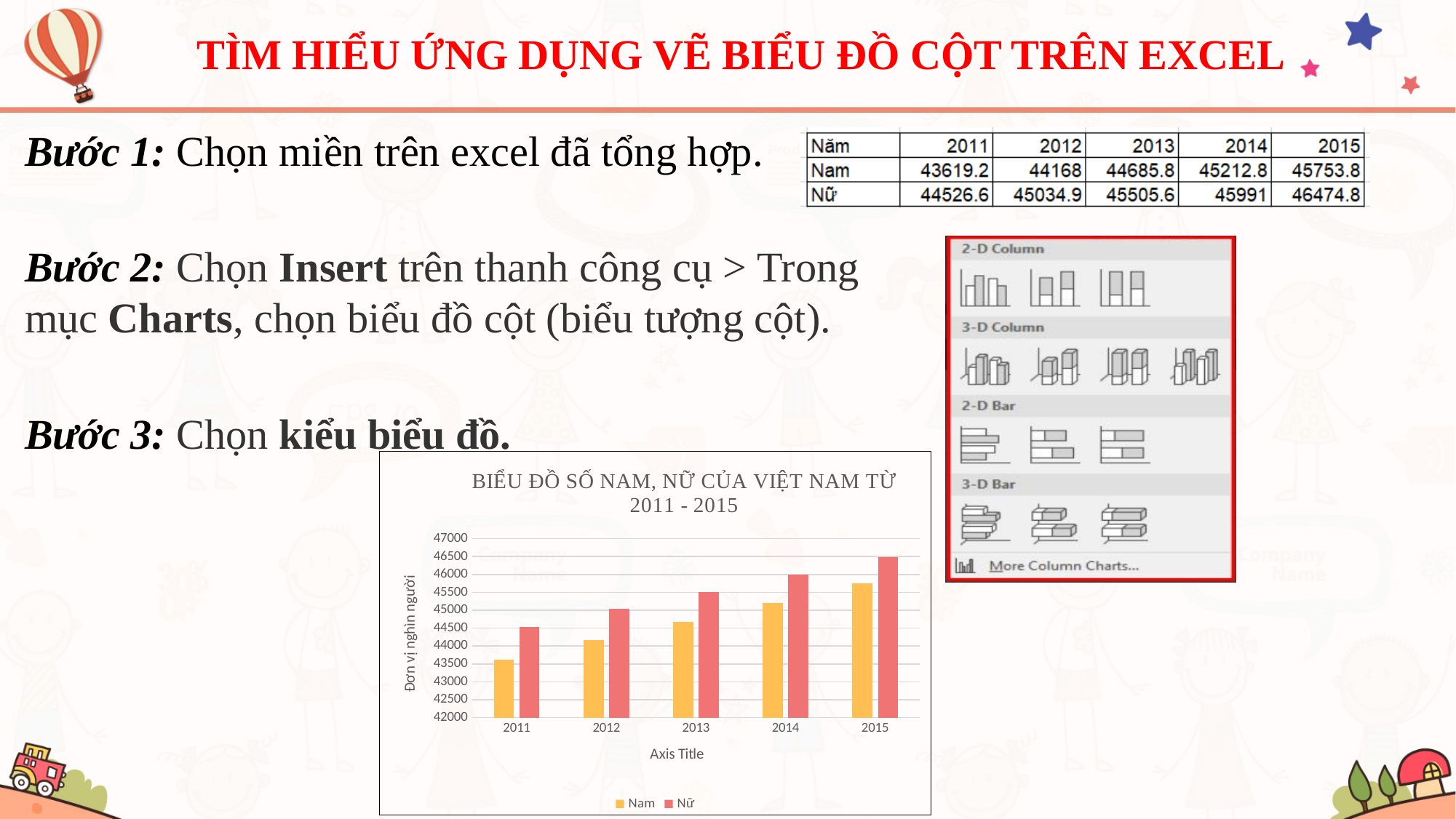
Is the value for Nam in 2011 greater or less than 44000? less What is the title of the chart's vertical axis? Đơn vị nghìn người In 2013, which series has the larger value, Nam or Nữ? Nữ What kind of chart is shown on the slide? bar chart What are the two entries in the chart legend? Nam and Nữ How many years are shown on the x axis of the chart? 5 Do the Nam values rise or fall from 2011 to 2015? rise Which series and year has the tallest bar in the chart? Nữ, 2015 How many series does the chart legend list? 2 Is the value for Nữ in 2015 greater or less than 46000? greater Which series and year has the shortest bar in the chart? Nam, 2011 Is the value for Nam in 2013 greater or less than 45000? less